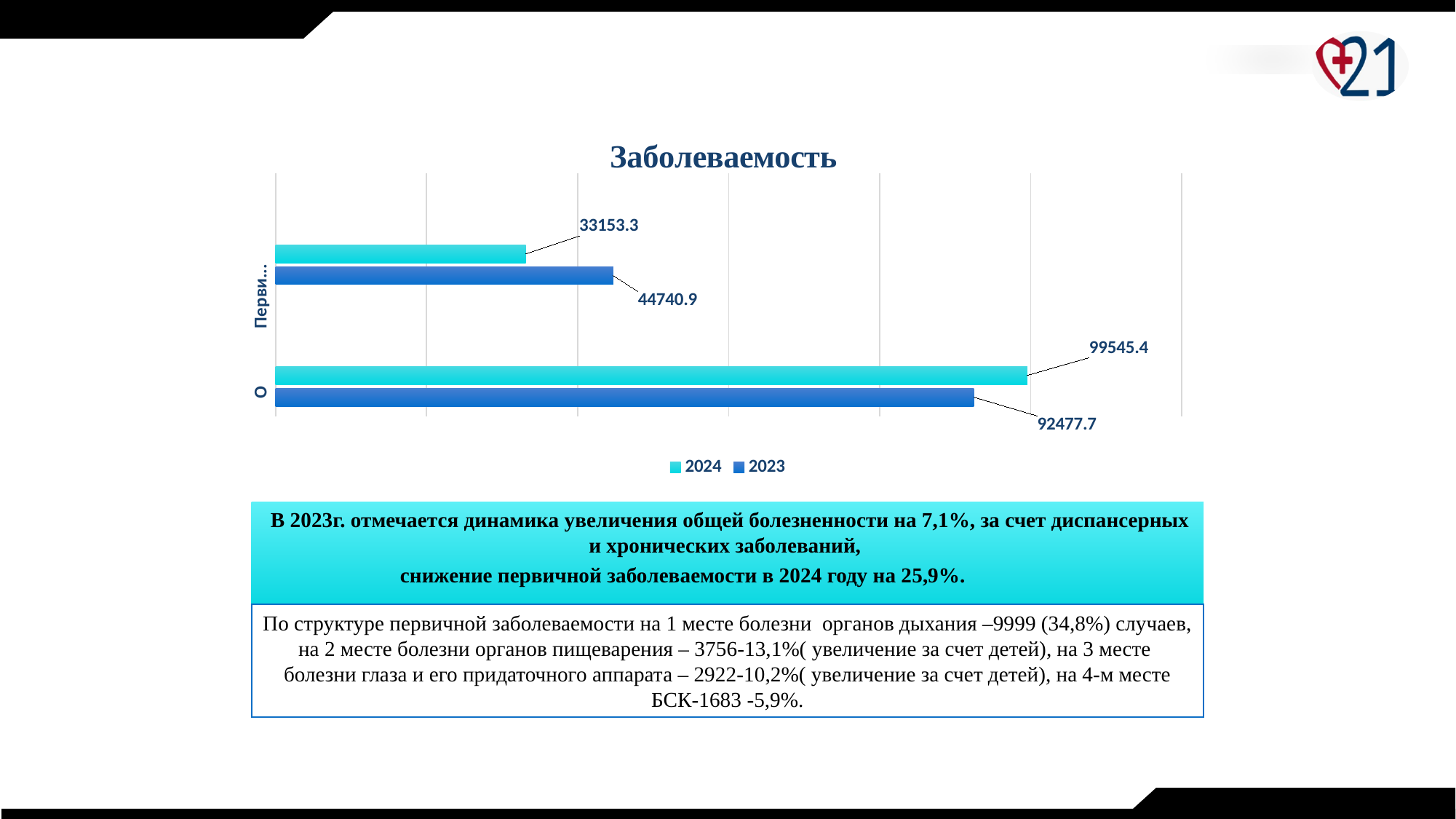
What is the 2023 value for the upper category (labelled 'Перви...')? 44740.9 What is the 2024 value for the lower category (labelled 'О')? 99545.4 Which series are listed in the chart legend? 2024 and 2023 What is the 2024 value for the upper category (labelled 'Перви...')? 33153.3 What is the 2023 value for the lower category (labelled 'О')? 92477.7 For the upper category (labelled 'Перви...'), which year has the larger value, 2024 or 2023? 2023 What is the title of the chart? Заболеваемость What is the highest value shown on the chart? 99545.4 What kind of chart is shown on the slide? bar chart How many categories are plotted on the chart? 2 How many series does the chart legend list? 2 For the lower category (labelled 'О'), what is the difference between the 2024 and 2023 values? 7067.7